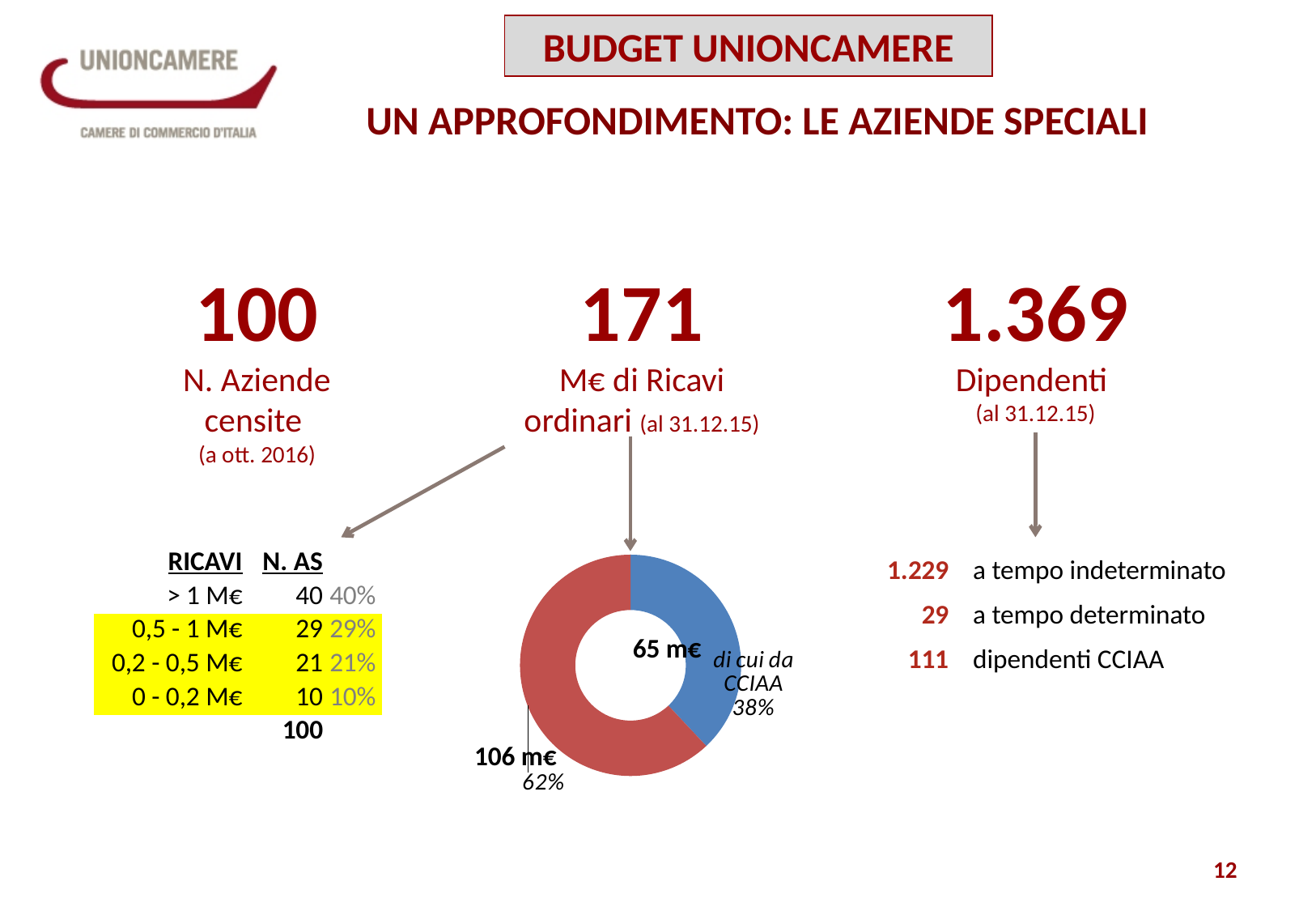
What is the difference in m€ between the two slices of the donut chart? 41 m€ What value is shown for the larger (red) slice of the donut chart? 106 m€ What kind of chart is shown on the slide? donut chart Which slice of the donut chart is the largest? 106 m€ (62%) Is the 'di cui da CCIAA' slice larger or smaller than the other slice in the donut chart? smaller What colour is the 'di cui da CCIAA' slice in the donut chart? blue What value is shown for the slice labelled 'di cui da CCIAA' in the donut chart? 65 m€ Which slice of the donut chart is the smallest? di cui da CCIAA (65 m€, 38%) How many slices does the donut chart have? 2 What share of the donut chart does the 106 m€ slice represent? 62% What is the total of the two slices of the donut chart in m€? 171 m€ What share of the donut chart does the 'di cui da CCIAA' slice represent? 38%